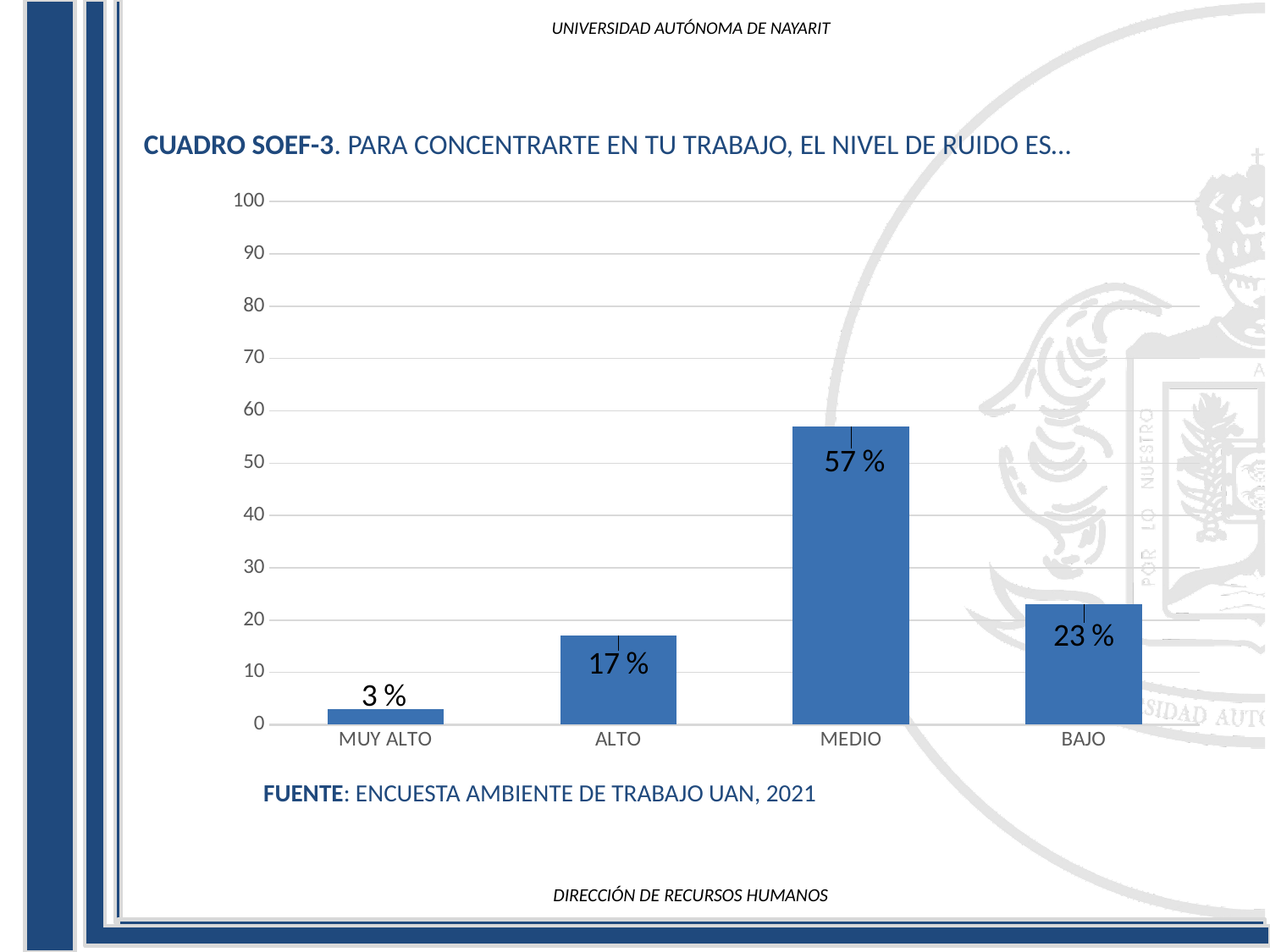
Is the value for MEDIO greater or less than 50? greater What is the value for MEDIO? 57 % What kind of chart is shown on the slide? bar chart How many categories are shown on the x axis? 4 What is the value for ALTO? 17 % What is the value for BAJO? 23 % Which category has the lowest value? MUY ALTO What is the value for MUY ALTO? 3 % What source is cited below the chart? ENCUESTA AMBIENTE DE TRABAJO UAN, 2021 What is the difference between the values for MEDIO and BAJO? 34 % Which category has the highest value? MEDIO Which is larger, the value for ALTO or the value for BAJO? BAJO